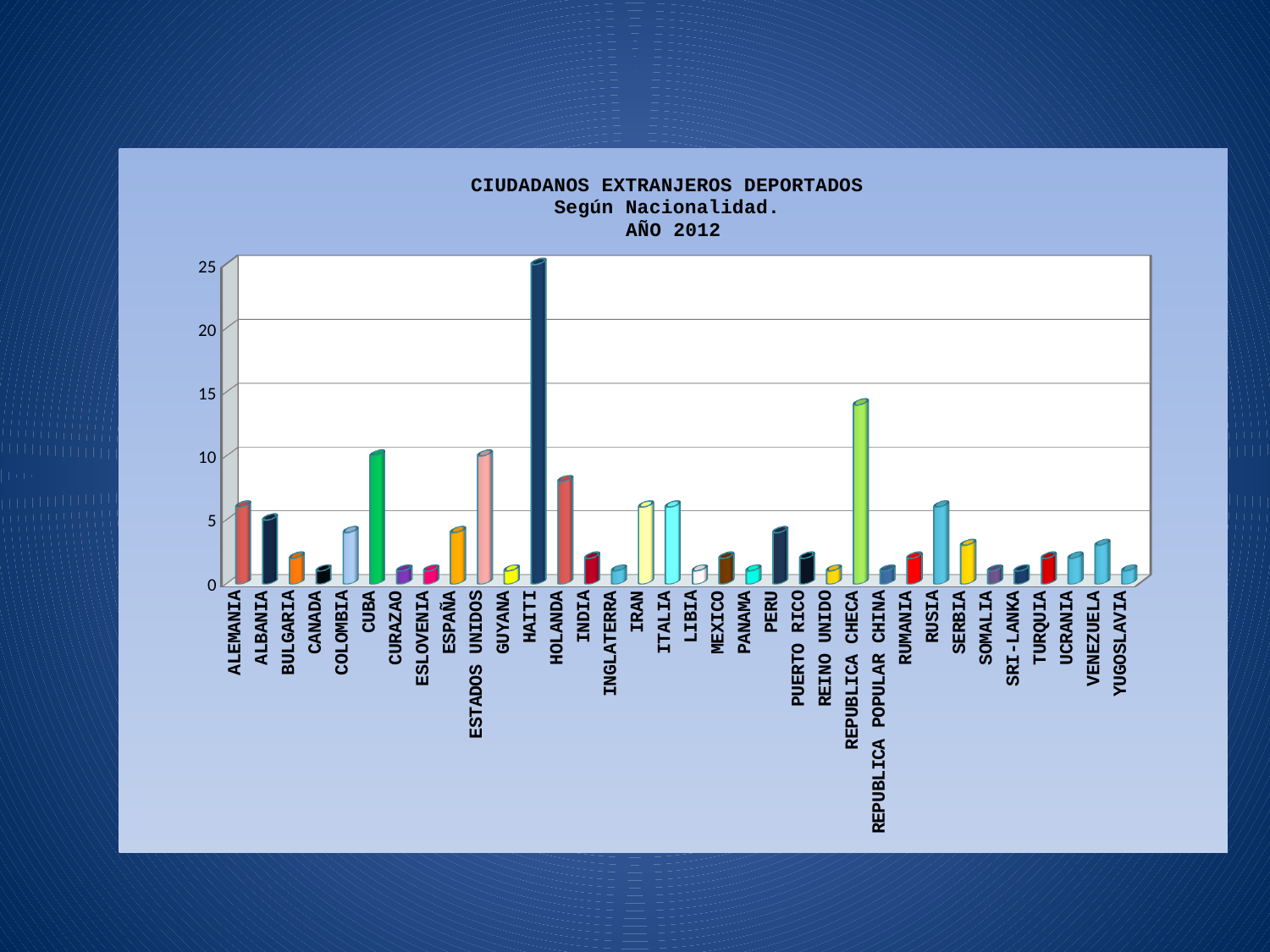
Is the value for CANADA greater or less than 5? less Is the value for REPUBLICA CHECA greater or less than 10? greater Is the value for VENEZUELA greater or less than 5? less Which year does the chart title say the data refers to? 2012 Which has a larger value, REPUBLICA CHECA or HOLANDA? REPUBLICA CHECA Which nationality has the highest number of deported foreign citizens? HAITI How many nationalities are shown on the x axis of the chart? 34 What kind of chart is shown on the slide? bar chart Which has a larger value, CUBA or COLOMBIA? CUBA Which has a larger value, HAITI or REPUBLICA CHECA? HAITI